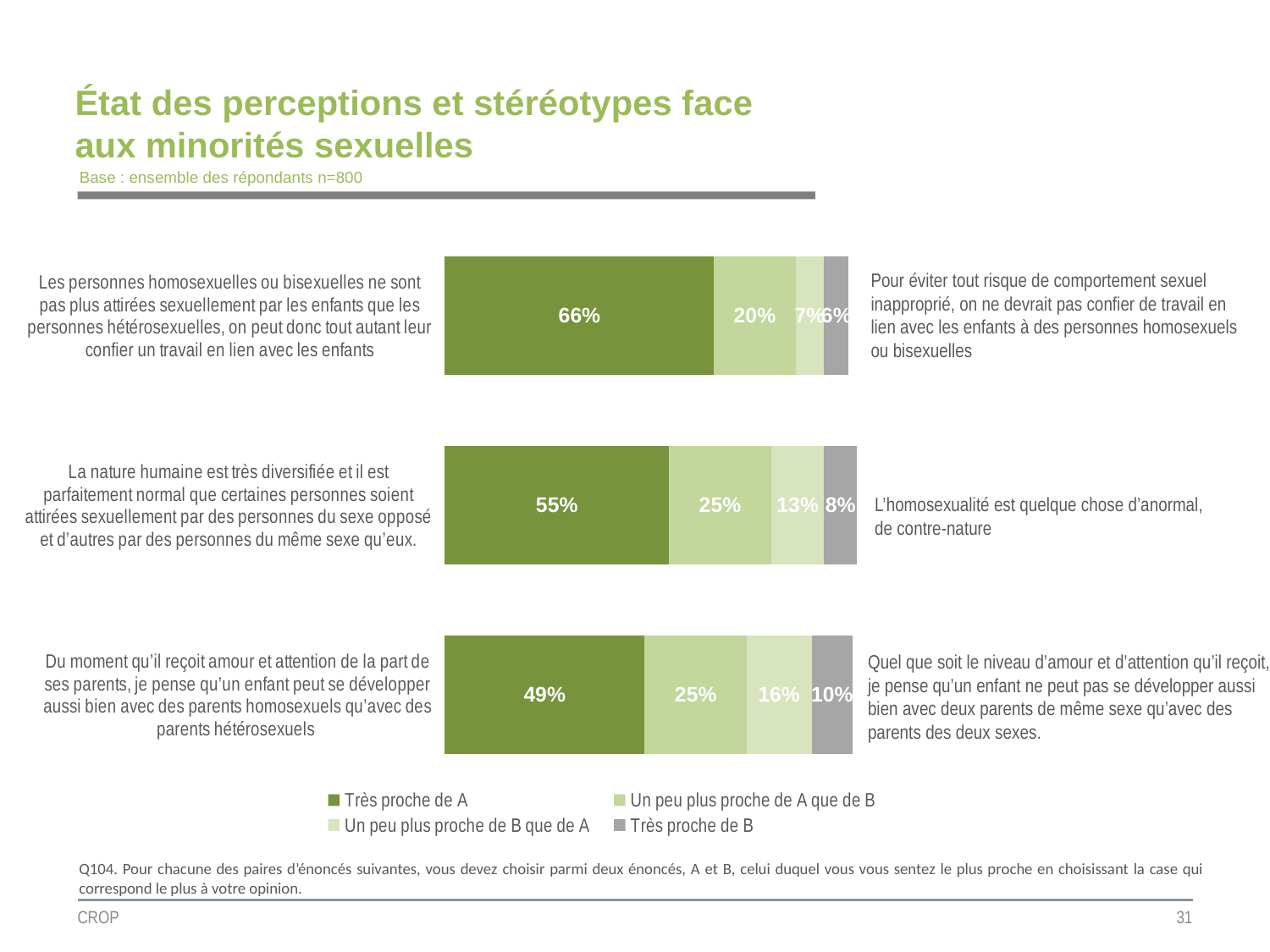
What kind of chart is shown on the slide? Stacked bar chart What is the 'Très proche de A' value for the top bar (statement about homosexual or bisexual people not being more attracted to children)? 66% Which is larger: the 'Un peu plus proche de B que de A' value for the middle bar or for the bottom bar? The bottom bar (16% vs 13%) What is the 'Un peu plus proche de A que de B' value for the middle bar (statement that human nature is very diversified)? 25% How many series does the legend list? 4 Which bar has the highest 'Très proche de A' value? The top bar (homosexual or bisexual people not more attracted to children), 66% What is the total of the four segments in the bottom bar (49%, 25%, 16%, 10%)? 100% How many stacked bars (pairs of statements) are plotted on the chart? 3 Do the 'Très proche de A' values rise or fall from the top bar to the bottom bar? Fall Which bar has the lowest 'Très proche de B' value? The top bar (homosexual or bisexual people not more attracted to children), 6% What is the 'Très proche de B' value for the bottom bar (statement about a child developing as well with homosexual parents)? 10% What is the difference between the 'Très proche de A' values of the top bar and the middle bar? 11 percentage points